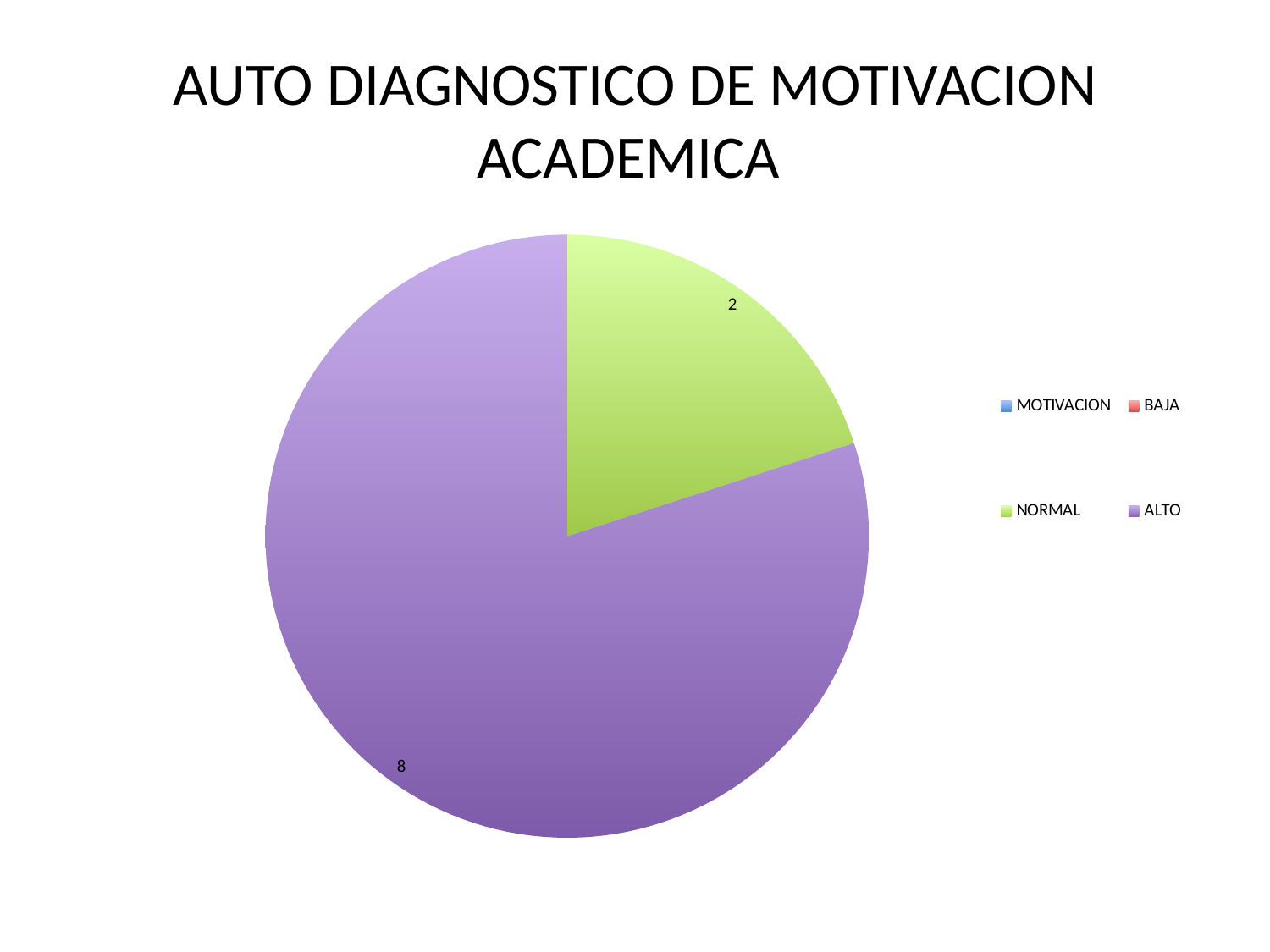
How many slices are visible in the pie? 2 Which category has the largest slice of the pie? ALTO What share of the pie does the NORMAL slice represent? 20% What is the value shown for the ALTO slice? 8 What is the value shown for the NORMAL slice? 2 Which is larger, the NORMAL slice or the ALTO slice? ALTO What colour is the ALTO slice? purple What is the title of the slide? AUTO DIAGNOSTICO DE MOTIVACION ACADEMICA What is the difference between the ALTO value and the NORMAL value? 6 What share of the pie does the ALTO slice represent? 80% What kind of chart is shown on the slide? pie chart How many entries does the legend list? 4